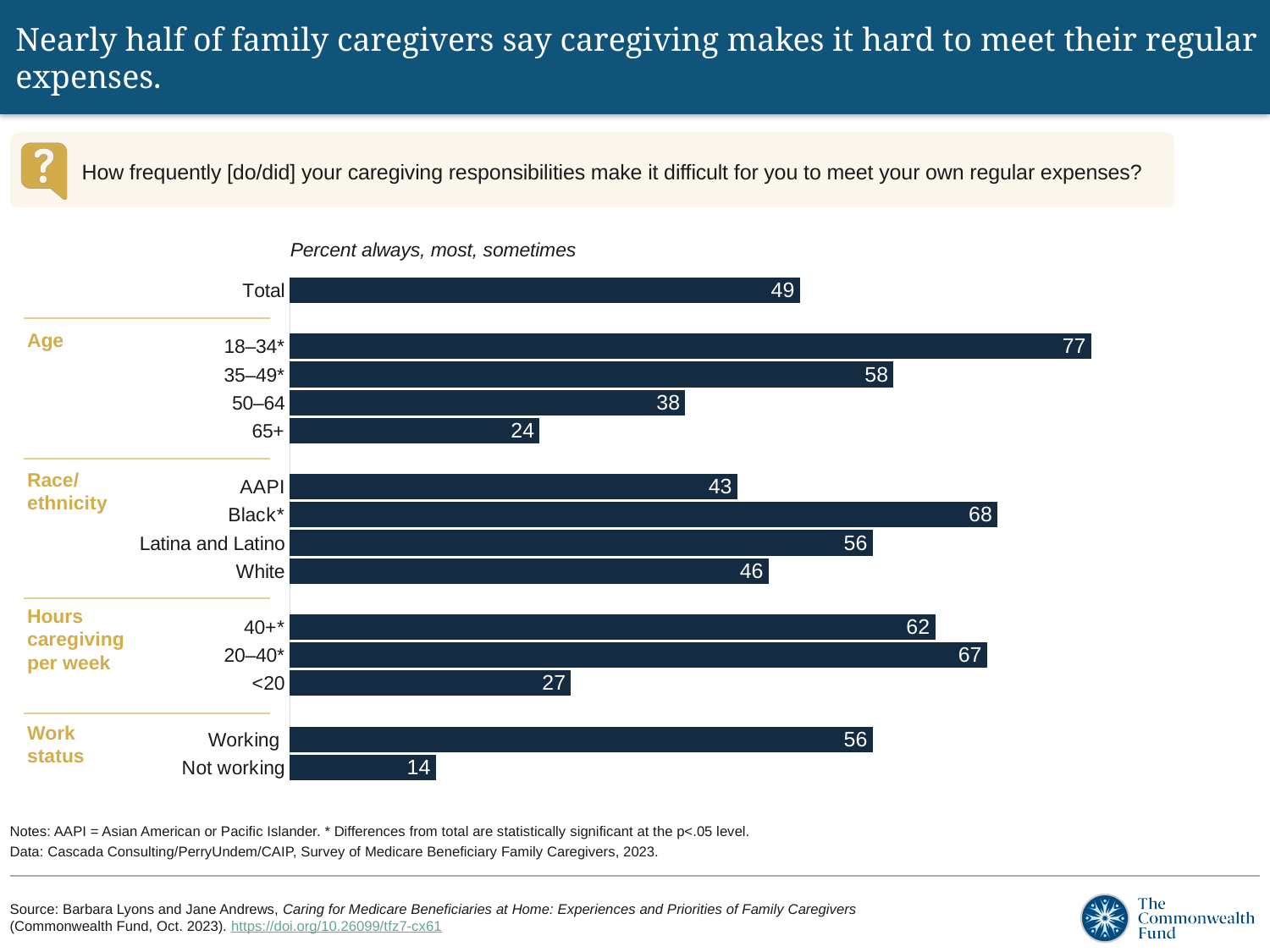
What is the difference between the values for Working and Not working? 42 What is the value for Black caregivers? 68 What is the value for the 18–34 age group? 77 What is the difference between the values for the 18–34 and 65+ age groups? 53 Which is larger, the value for AAPI or White? White Which category has the highest value on the chart? 18–34 Which category has the lowest value on the chart? Not working How many categories (bars) are shown on the chart? 14 Which is larger, the value for 40+ hours caregiving per week or 20–40 hours? 20–40 What kind of chart is shown on the slide? Bar chart What is the value for Not working? 14 What is the value for Total? 49